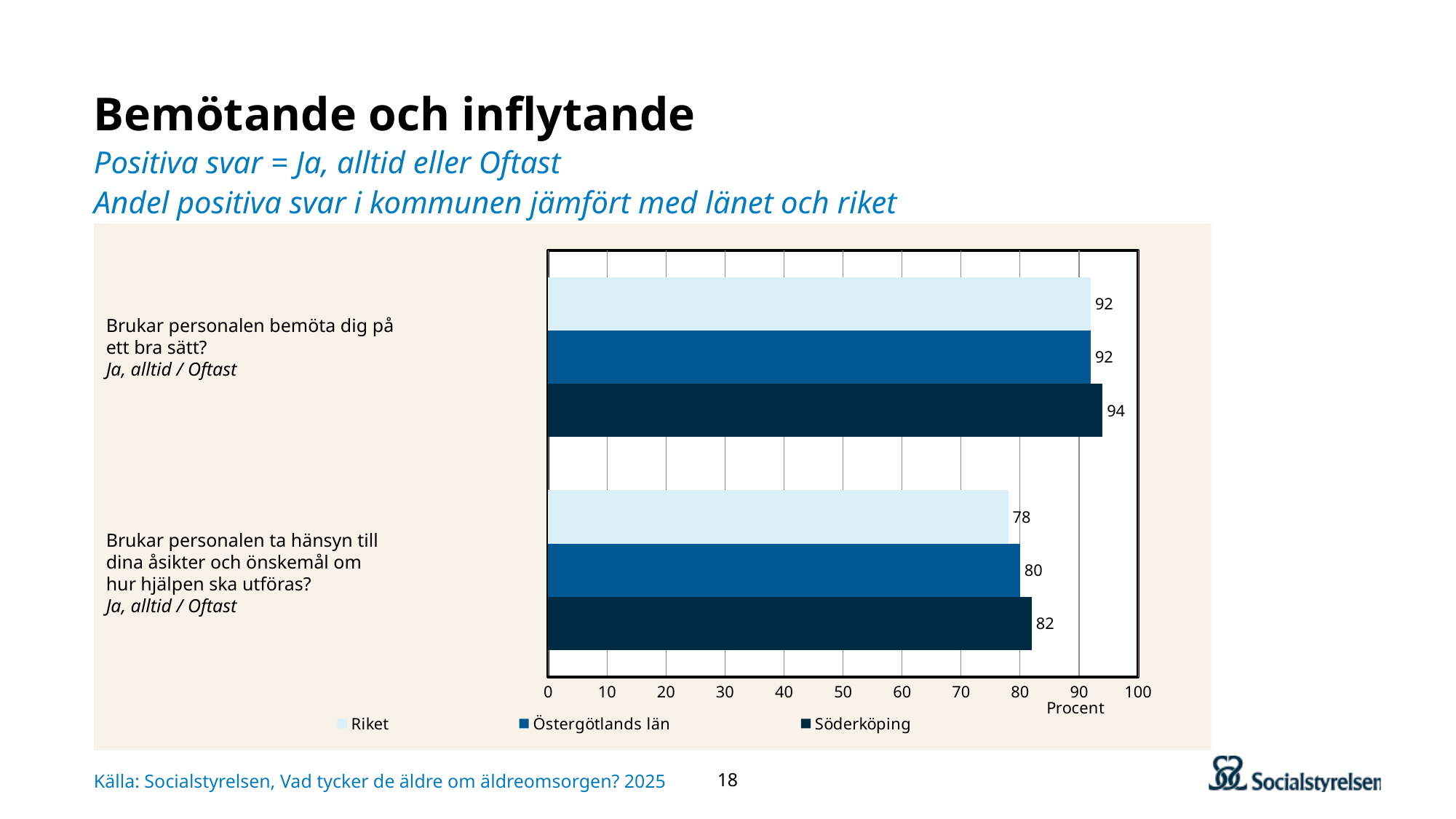
Which series has the lowest value on the question "Brukar personalen ta hänsyn till dina åsikter och önskemål om hur hjälpen ska utföras?"? Riket What kind of chart is shown on the slide? Bar chart Which is larger: Söderköping's value for "Brukar personalen bemöta dig på ett bra sätt?" or Söderköping's value for "Brukar personalen ta hänsyn till dina åsikter och önskemål om hur hjälpen ska utföras?"? Brukar personalen bemöta dig på ett bra sätt? What unit is shown on the horizontal axis of the chart? Procent Which series has the highest value on the question "Brukar personalen ta hänsyn till dina åsikter och önskemål om hur hjälpen ska utföras?"? Söderköping How many series does the legend list? 3 Is the value for Riket on "Brukar personalen ta hänsyn till dina åsikter och önskemål om hur hjälpen ska utföras?" greater or less than 80? less What is the difference between Söderköping and Riket on the question "Brukar personalen bemöta dig på ett bra sätt?"? 2 What is the value for Söderköping on the question "Brukar personalen bemöta dig på ett bra sätt?"? 94 What is the value for Östergötlands län on the question "Brukar personalen ta hänsyn till dina åsikter och önskemål om hur hjälpen ska utföras?"? 80 What is the value for Riket on the question "Brukar personalen ta hänsyn till dina åsikter och önskemål om hur hjälpen ska utföras?"? 78 What is the difference between Söderköping and Riket on the question "Brukar personalen ta hänsyn till dina åsikter och önskemål om hur hjälpen ska utföras?"? 4